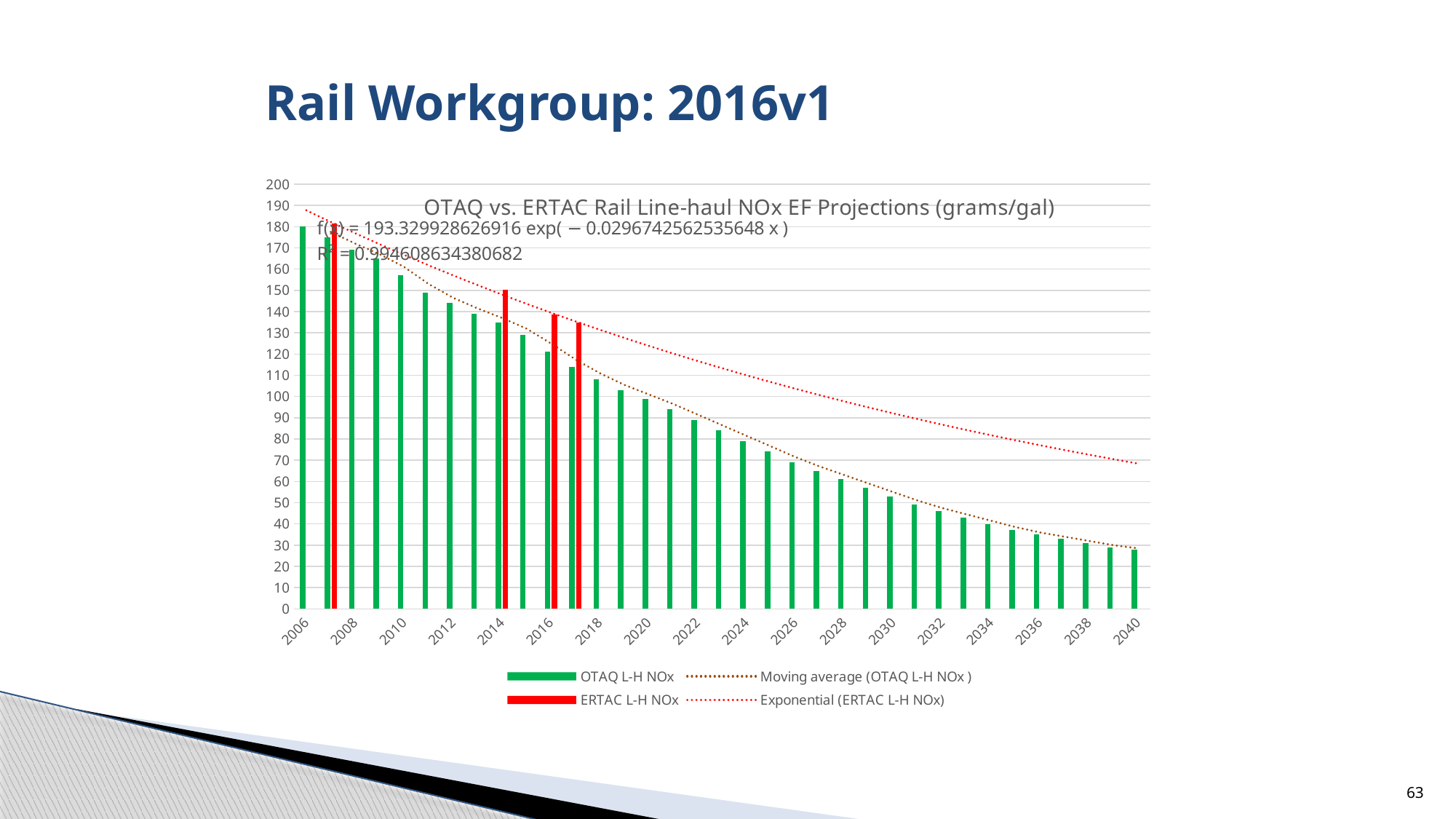
How many red ERTAC L-H NOx bars are plotted on the chart? 4 Is the OTAQ L-H NOx value for 2010 greater or less than 150? greater Which year has the highest OTAQ L-H NOx value? 2006 What kind of chart is shown on the slide? bar chart Do the OTAQ L-H NOx values rise or fall from 2006 to 2040? fall Is the ERTAC L-H NOx value for 2016 greater or less than 130? greater Is the OTAQ L-H NOx value for 2040 greater or less than 30? less In 2014, which is larger: the ERTAC L-H NOx value or the OTAQ L-H NOx value? ERTAC L-H NOx Which year has the lowest OTAQ L-H NOx value? 2040 What is the title of the chart? OTAQ vs. ERTAC Rail Line-haul NOx EF Projections (grams/gal) How many entries does the chart legend list? 4